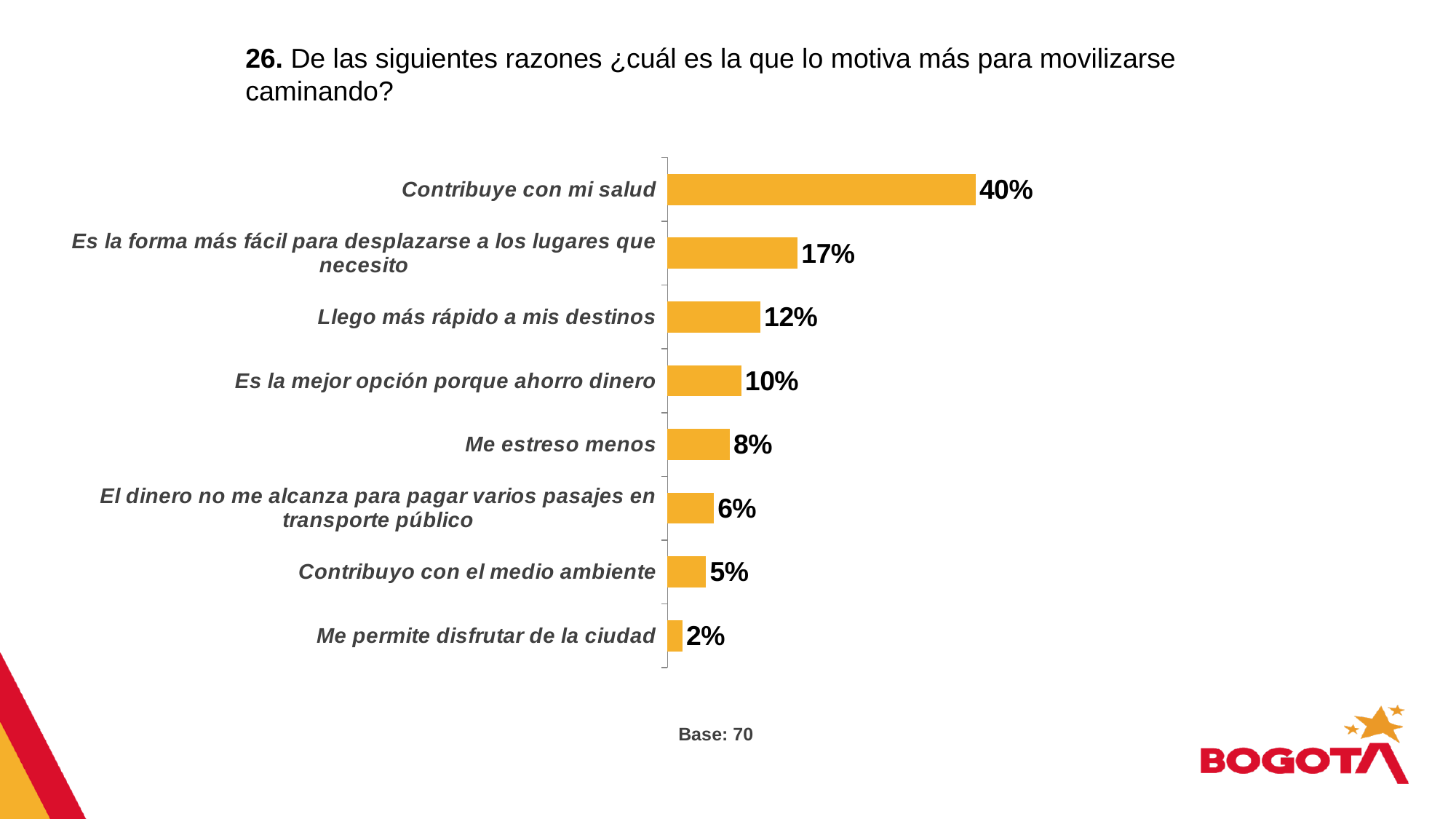
Which is larger, "Llego más rápido a mis destinos" or "Me estreso menos"? Llego más rápido a mis destinos What is the value for "Contribuye con mi salud"? 40% Which category has the lowest value? Me permite disfrutar de la ciudad What is the value for "Llego más rápido a mis destinos"? 12% What is the value for "Me estreso menos"? 8% What is the difference between "Es la mejor opción porque ahorro dinero" and "El dinero no me alcanza para pagar varios pasajes en transporte público"? 4% What is the value for "Contribuyo con el medio ambiente"? 5% How many categories are shown in the chart? 8 What is the difference between "Contribuye con mi salud" and "Es la forma más fácil para desplazarse a los lugares que necesito"? 23% Which category has the highest value? Contribuye con mi salud What kind of chart is shown on the slide? Bar chart What base (number of respondents) is stated below the chart? Base: 70